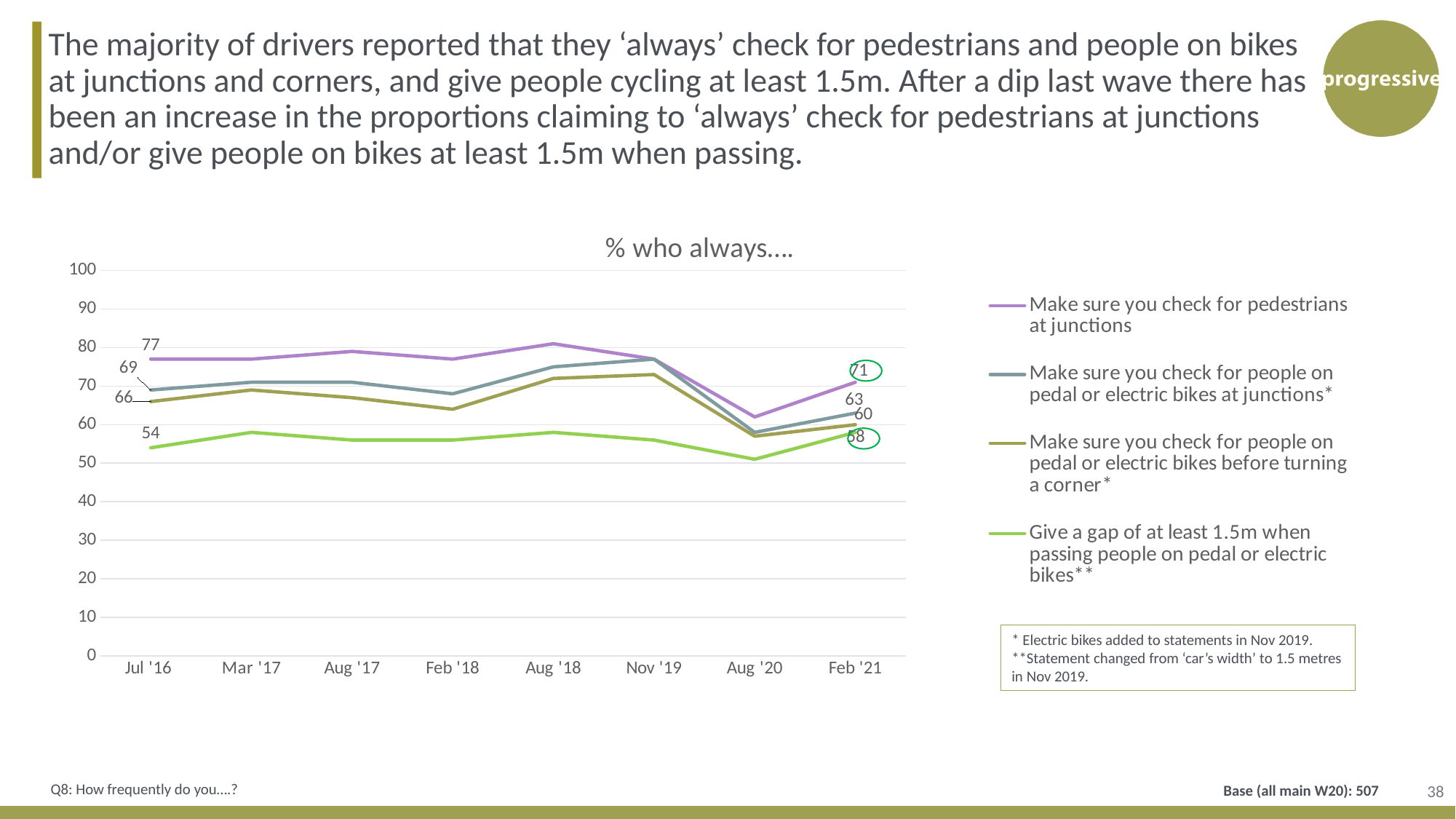
What is the value for 'Make sure you check for people on pedal or electric bikes before turning a corner' in Jul '16? 66 What is the value for 'Give a gap of at least 1.5m when passing people on pedal or electric bikes' in Feb '21? 58 What type of chart is shown on the slide? line chart What is the difference between the Jul '16 and Feb '21 values for 'Make sure you check for pedestrians at junctions'? 6 Which series has the highest value in Feb '21? Make sure you check for pedestrians at junctions Which series has the lowest value in Jul '16? Give a gap of at least 1.5m when passing people on pedal or electric bikes How many time points are shown on the x axis of the chart? 8 What is the value for 'Make sure you check for people on pedal or electric bikes at junctions' in Feb '21? 63 How many series does the chart legend list? 4 What is the value for 'Make sure you check for pedestrians at junctions' in Jul '16? 77 Is the value for 'Make sure you check for pedestrians at junctions' in Aug '20 greater or less than 70? less What is the title of the chart? % who always….